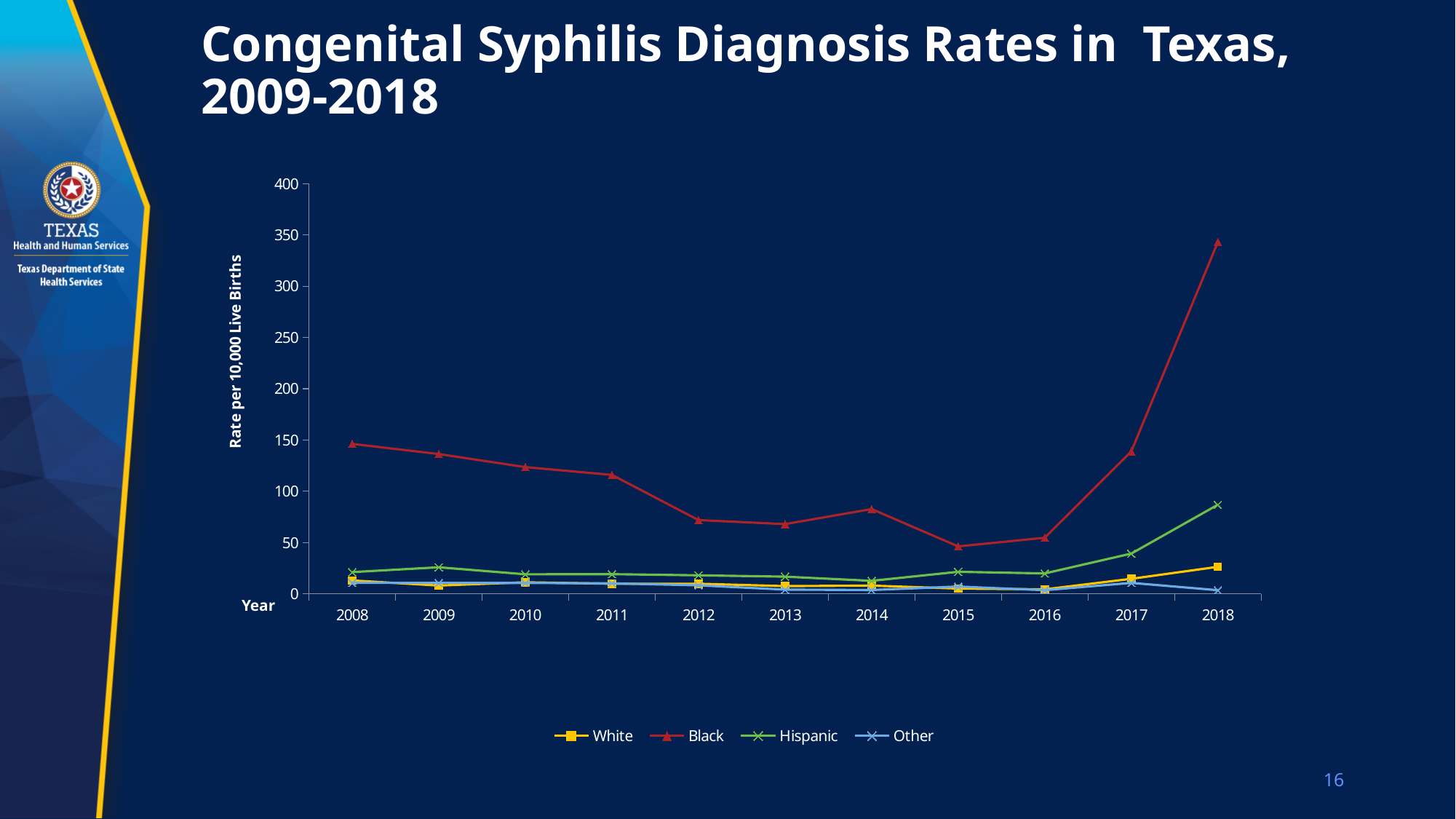
What is the label on the y axis? Rate per 10,000 Live Births In 2018, which is larger, the value for Hispanic or the value for White? Hispanic How many series does the legend list? 4 How many years are plotted along the x axis? 11 Is the value for White in 2018 greater or less than 50? less What kind of chart is shown on the slide? line chart Is the value for Black in 2018 greater or less than 300? greater Is the value for Hispanic in 2018 greater or less than 50? greater Which series has the highest value in 2018? Black Does the Black series rise or fall from 2008 to 2015? fall In which year does the Black series reach its highest value? 2018